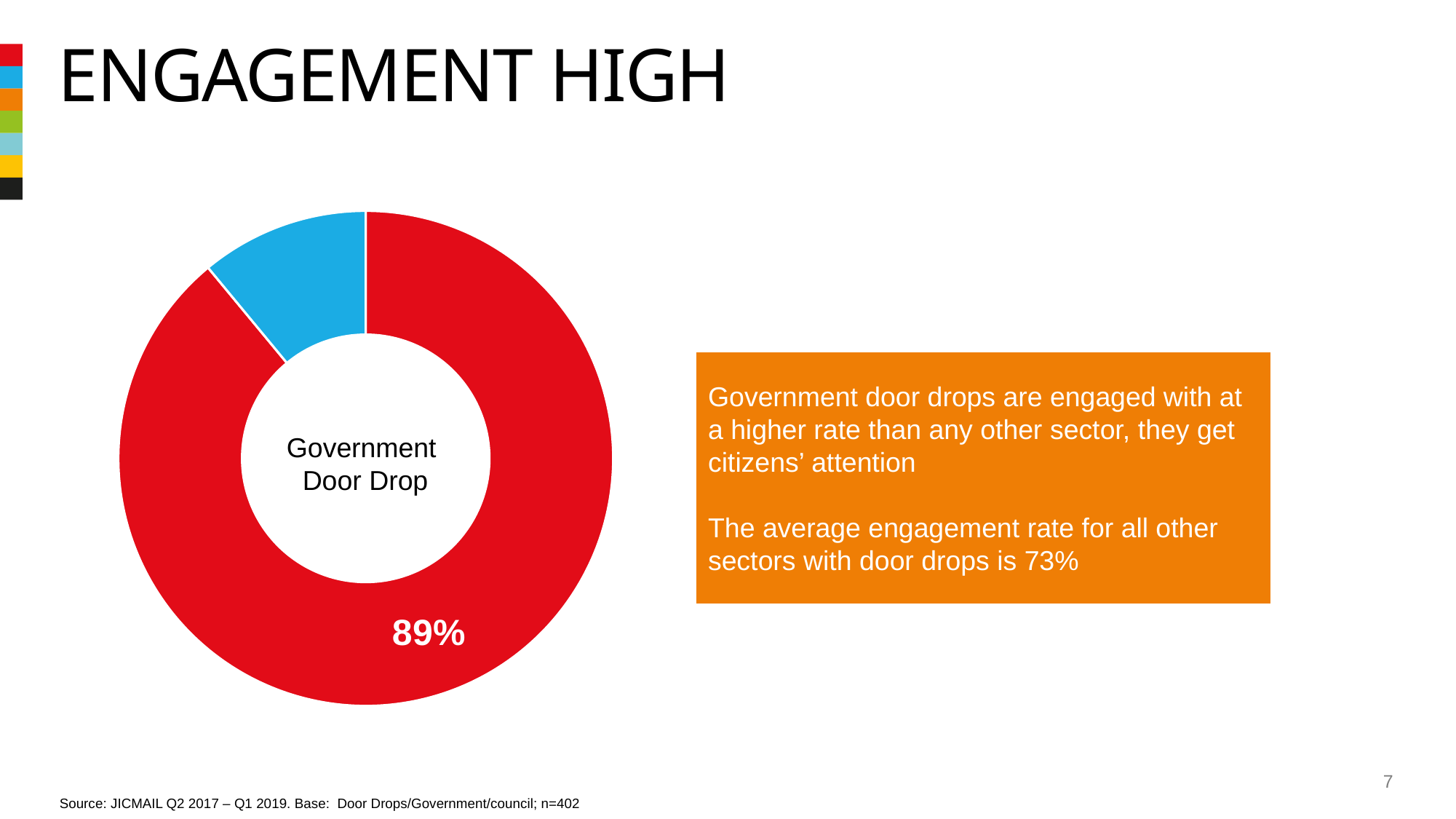
What kind of chart is shown on the slide? Pie chart (donut) How many segments does the donut chart have? 2 What share of the donut chart does the red segment represent? 89% Which segment of the donut chart is larger, the red one or the blue one? The red one What percentage is printed on the red segment of the donut chart? 89% Is the value of the red segment greater or less than 50%? greater What label appears in the centre of the donut chart? Government Door Drop What is the title of the slide containing the donut chart? ENGAGEMENT HIGH